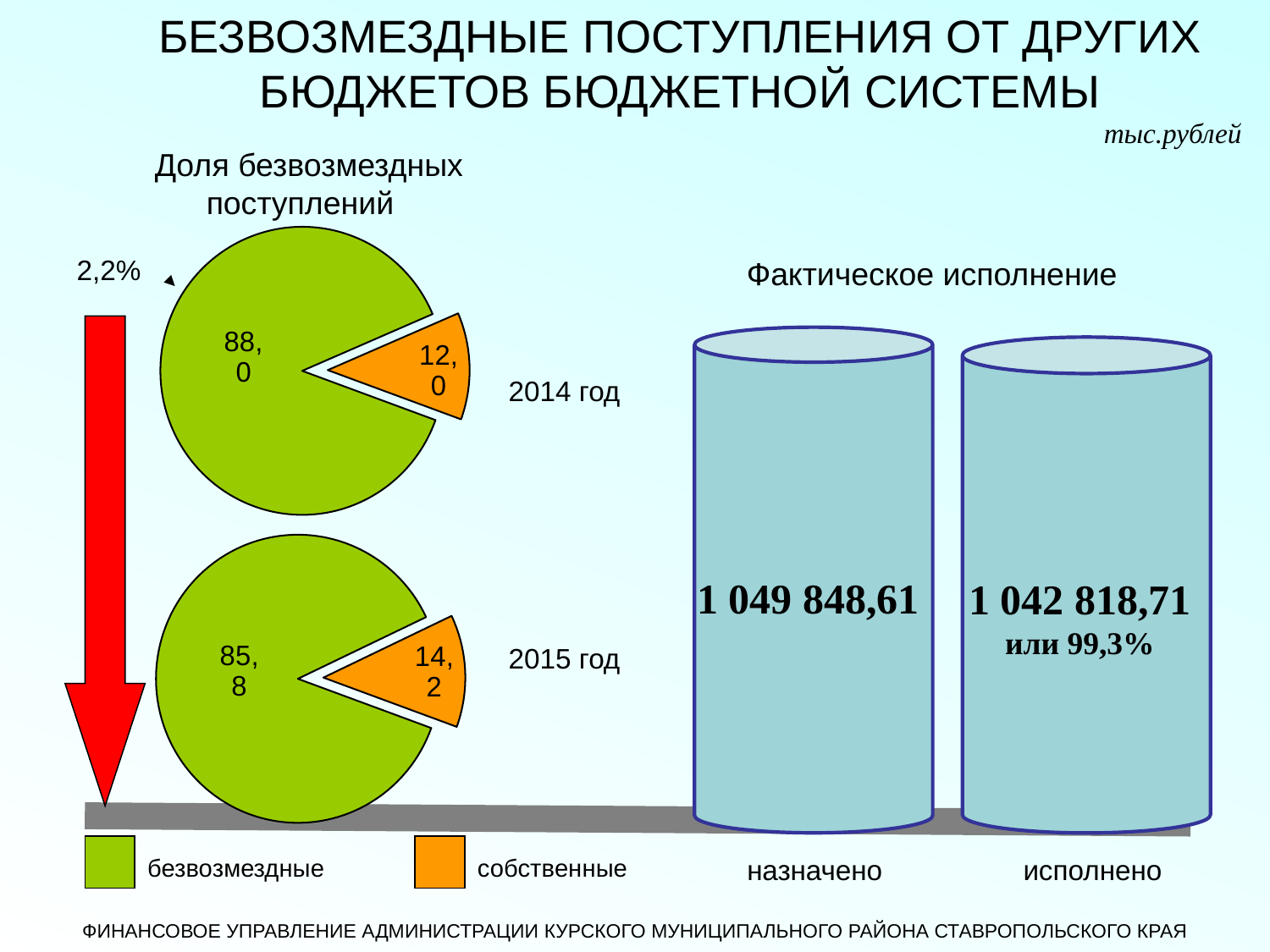
In the 2014 pie chart (2014 год), what is the value shown for the безвозмездные slice? 88,0 In the 2015 pie chart (2015 год), what is the difference between the безвозмездные and собственные values? 71,6 In the 2015 pie chart (2015 год), what is the value shown for the собственные slice? 14,2 According to the legend, what colour represents безвозмездные in the pie charts? Green By how much does the безвозмездные share in the 2014 pie chart exceed the безвозмездные share in the 2015 pie chart? 2,2 What kind of chart is used to show the Доля безвозмездных поступлений for 2014 and 2015? Pie chart In the 2015 pie chart (2015 год), what is the value shown for the безвозмездные slice? 85,8 In the 2014 pie chart (2014 год), what is the value shown for the собственные slice? 12,0 How many slices does the 2015 pie chart (2015 год) have? 2 In the 2015 pie chart (2015 год), which slice is the largest? безвозмездные How many entries does the legend below the pie charts list? 2 Which year has the larger безвозмездные share, 2014 or 2015? 2014